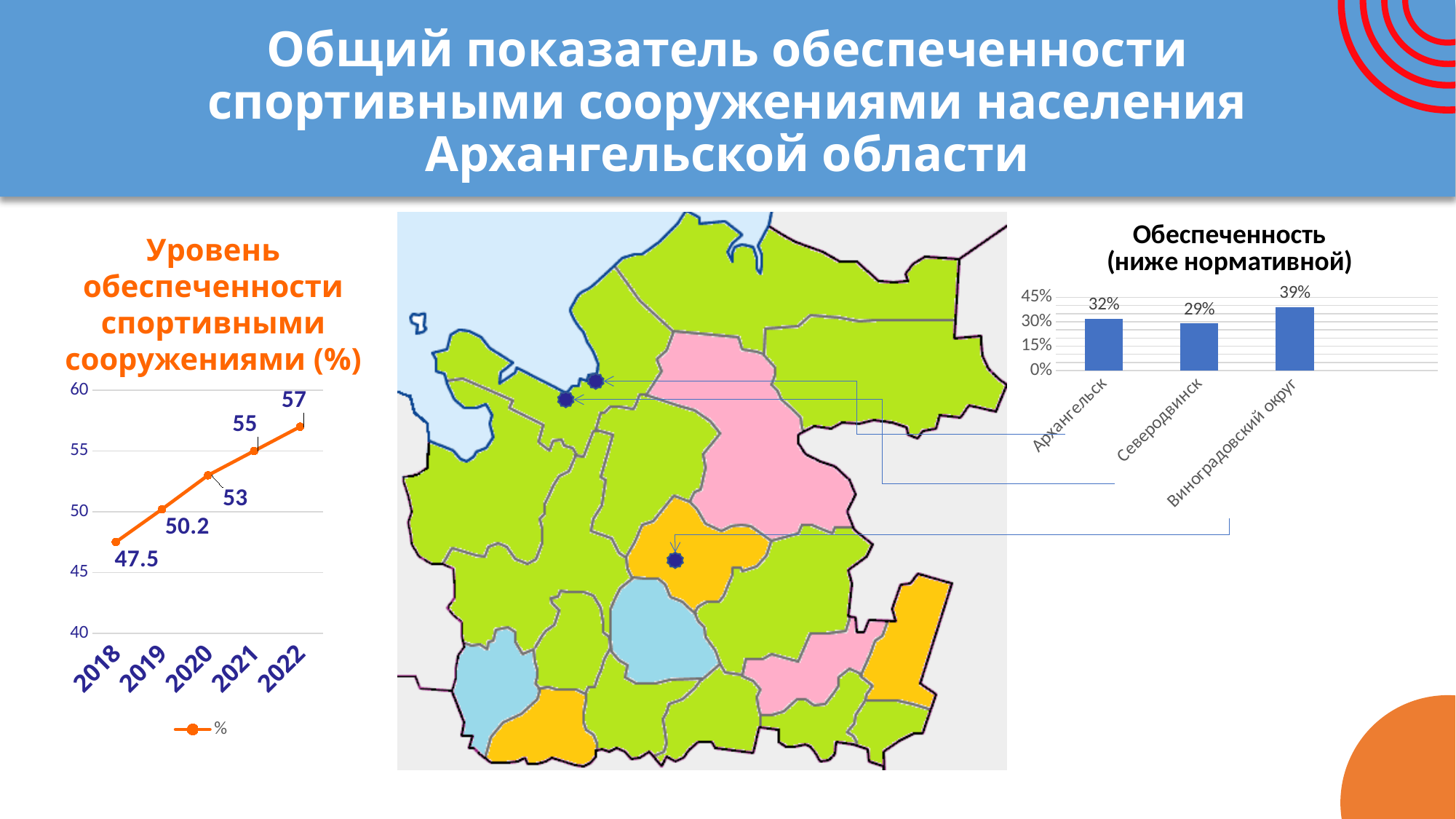
In the bar chart 'Обеспеченность (ниже нормативной)', which category has the lowest value? Северодвинск In the line chart 'Уровень обеспеченности спортивными сооружениями (%)', what is the value for 2018? 47.5 In the bar chart 'Обеспеченность (ниже нормативной)', what is the value for Северодвинск? 29% In the bar chart 'Обеспеченность (ниже нормативной)', what is the difference between Виноградовский округ and Архангельск? 7% In the line chart 'Уровень обеспеченности спортивными сооружениями (%)', which year has the highest value? 2022 In the line chart 'Уровень обеспеченности спортивными сооружениями (%)', what is the difference between the 2022 and 2018 values? 9.5 What type of chart is 'Обеспеченность (ниже нормативной)'? bar chart In the bar chart 'Обеспеченность (ниже нормативной)', which category has the highest value? Виноградовский округ In the line chart 'Уровень обеспеченности спортивными сооружениями (%)', what is the value for 2020? 53 What type of chart is 'Уровень обеспеченности спортивными сооружениями (%)'? line chart In the line chart 'Уровень обеспеченности спортивными сооружениями (%)', do the values rise or fall from 2018 to 2022? rise How many years are plotted in the line chart 'Уровень обеспеченности спортивными сооружениями (%)'? 5